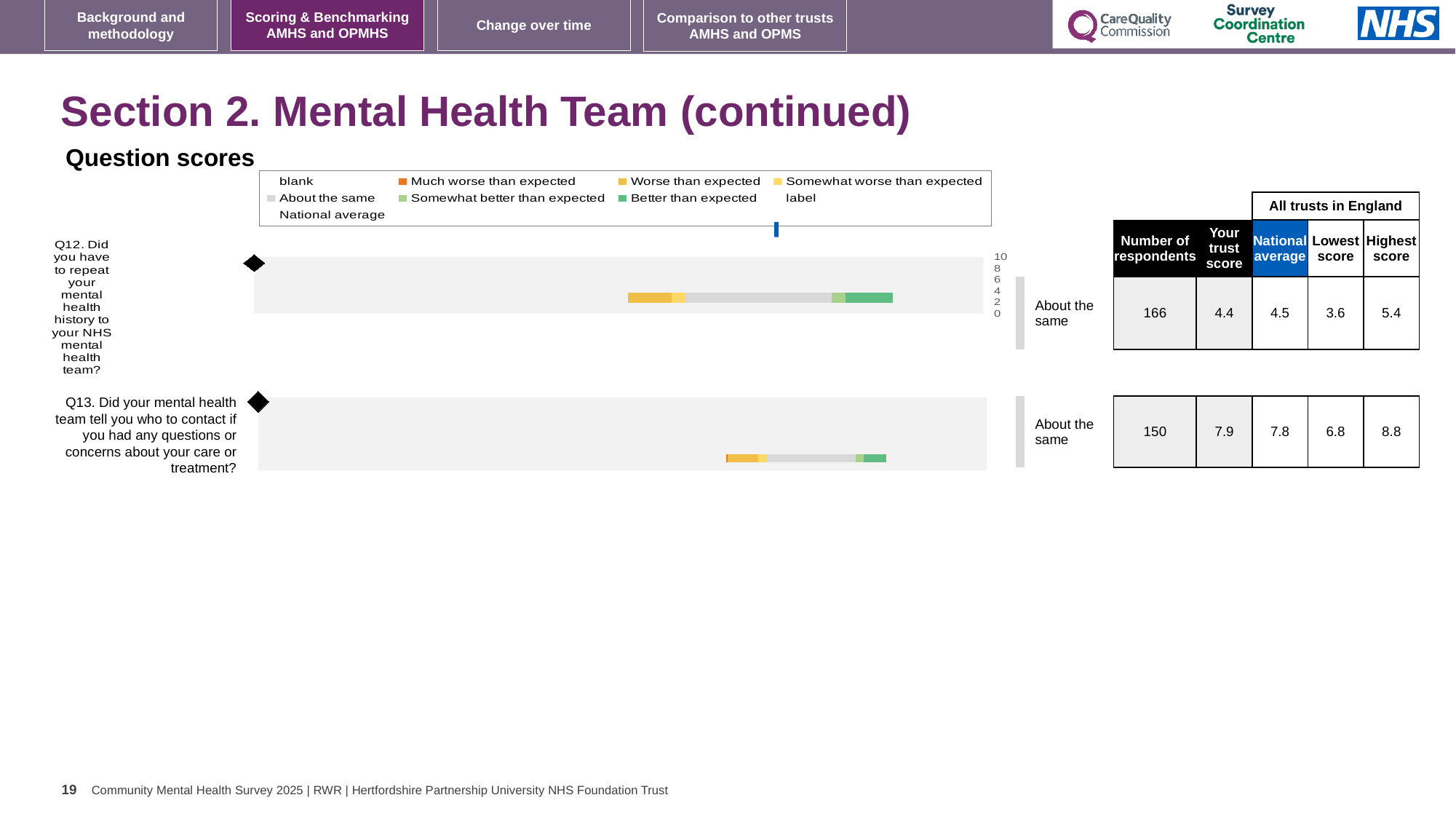
What benchmark category is shown next to the bar for Q12? About the same What is the trust score for Q13 (told who to contact with questions or concerns)? 7.9 What is the number of respondents for Q13? 150 What is the difference between the highest and lowest score for Q12? 1.8 What is the highest score among all trusts in England for Q13? 8.8 What kind of chart is used to show the question scores for Q12 and Q13? bar chart What is the trust score for Q12 (repeating mental health history)? 4.4 Which is larger for Q13, the trust score or the national average? trust score Which question has the higher trust score, Q12 or Q13? Q13 What is the lowest score among all trusts in England for Q12? 3.6 How many questions are plotted in the question scores chart? 2 What is the national average for Q12? 4.5